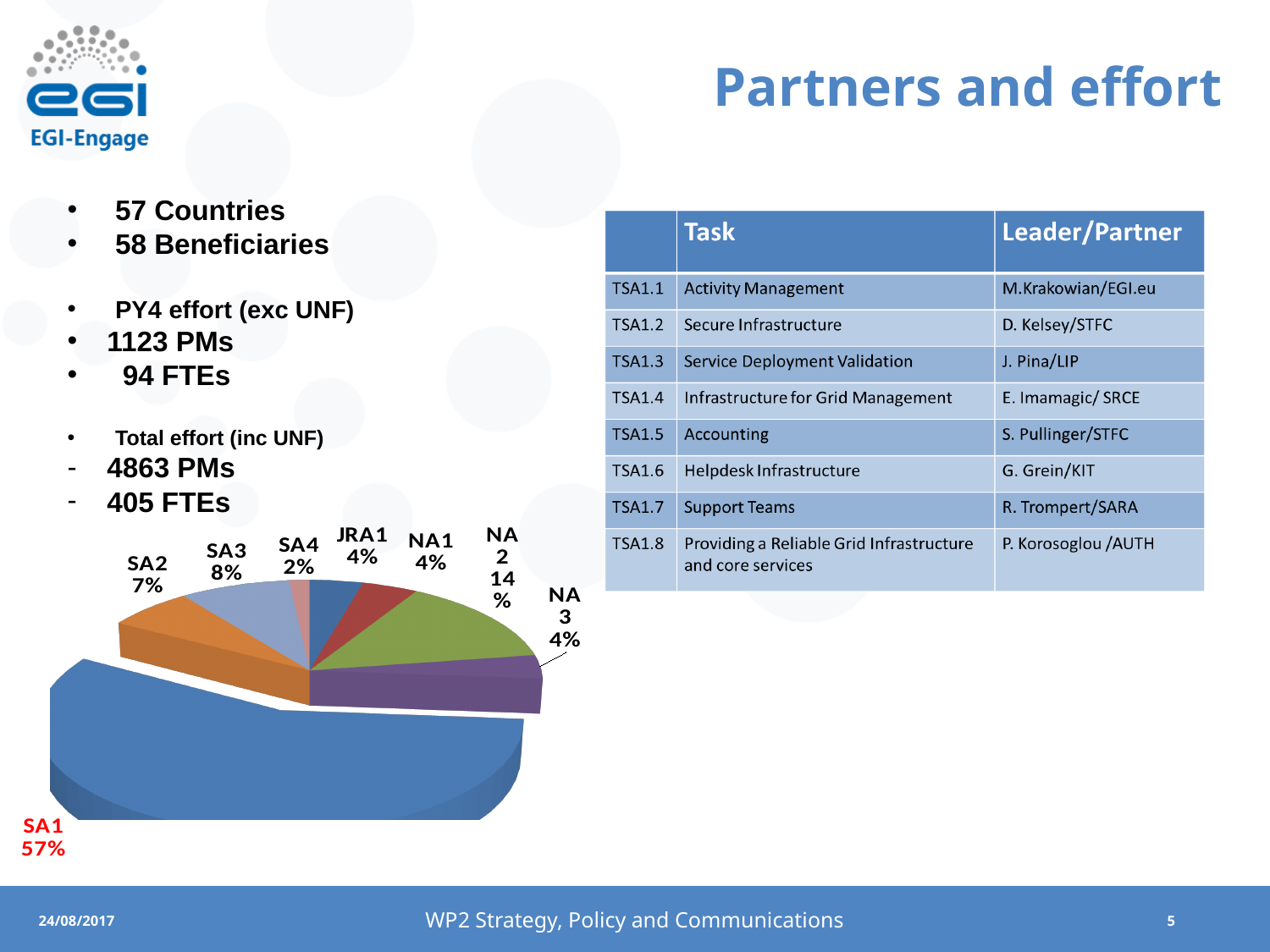
What kind of chart is shown on the slide? Pie chart What is the combined share of SA2 and SA3 in the pie chart? 15% What percentage is shown for NA2 in the pie chart? 14% What share of the pie chart does SA1 have? 57% What is the difference in percentage points between SA1 and NA2 in the pie chart? 43 Which is larger in the pie chart, SA2 or SA3? SA3 Which slice of the pie chart is labelled in red text? SA1 What percentage is shown for SA4 in the pie chart? 2% How many slices does the pie chart have? 8 What percentage is shown for SA3 in the pie chart? 8% Which slice of the pie chart is the smallest? SA4 Which slice of the pie chart is the largest? SA1